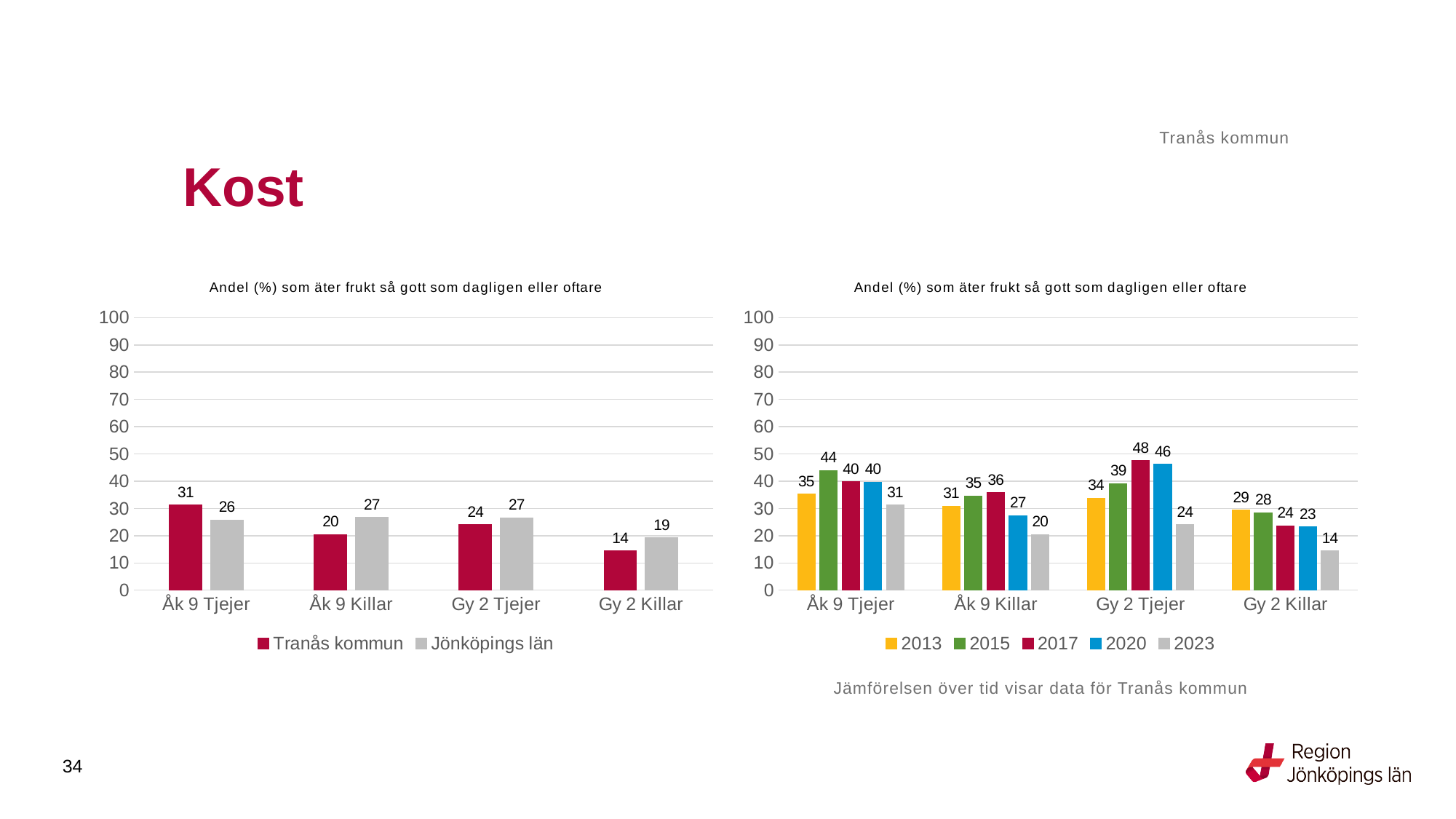
What kind of chart is the right chart? Bar chart In the left chart, what is the difference between Jönköpings län and Tranås kommun for Åk 9 Killar? 7 In the right chart, what is the difference between the 2013 and 2023 values for Gy 2 Killar? 15 In the left chart, how many series does the legend list? 2 In the left chart, which is larger for Åk 9 Tjejer: Tranås kommun or Jönköpings län? Tranås kommun In the right chart, which year has the highest value for Åk 9 Tjejer? 2015 In the left chart, what is the value for Jönköpings län for Gy 2 Killar? 19 In the left chart, what is the value for Tranås kommun for Åk 9 Tjejer? 31 In the right chart, how many series does the legend list? 5 In the left chart, which category has the lowest value for Tranås kommun? Gy 2 Killar In the right chart, what is the value for 2017 for Gy 2 Tjejer? 48 In the right chart, what is the value for 2023 for Åk 9 Killar? 20